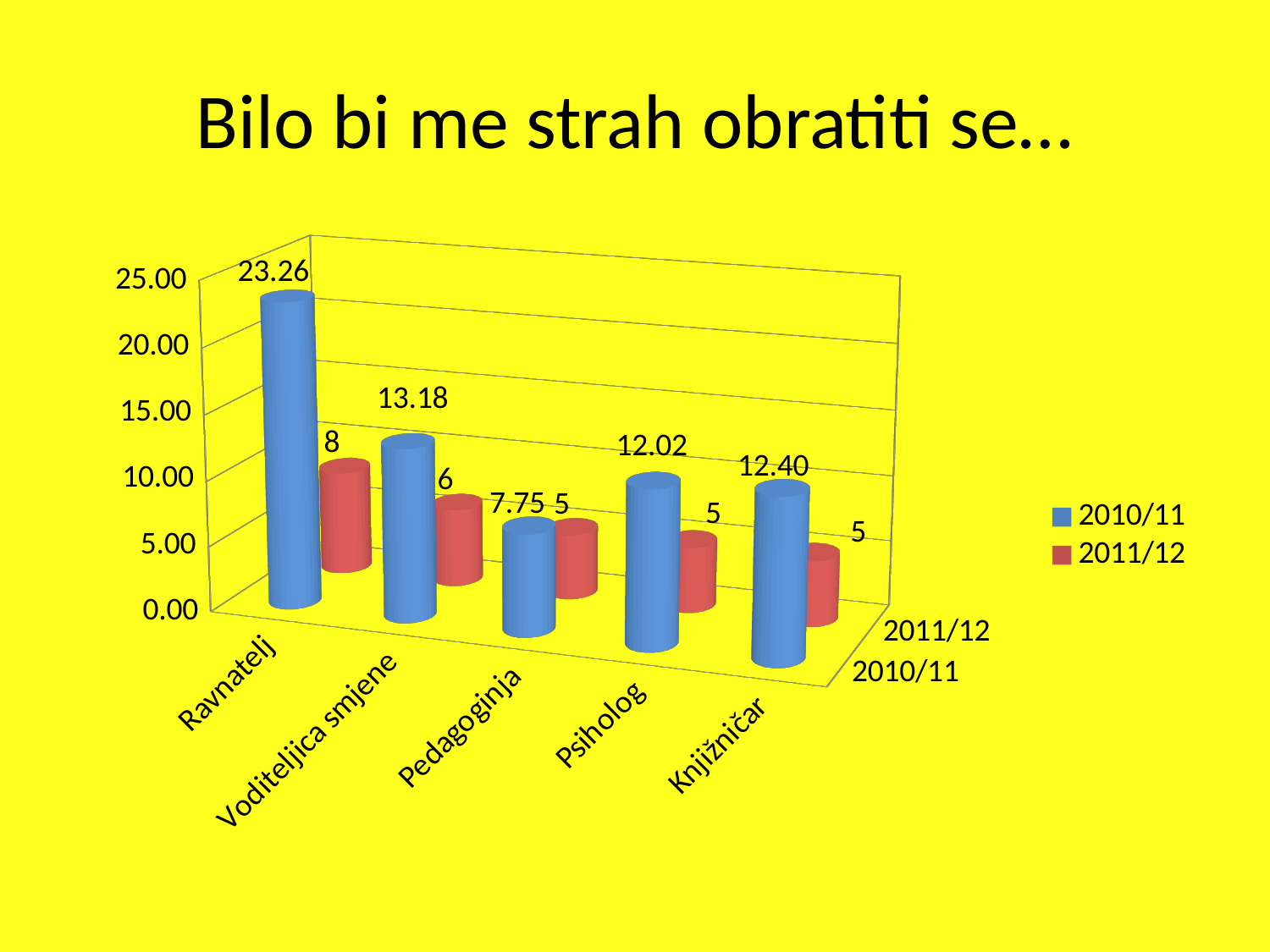
How many series does the legend list? 2 Which category has the highest value in the 2011/12 series? Ravnatelj What type of chart is shown on the slide? Bar chart What is the value for Voditeljica smjene in the 2011/12 series? 6 Which category has the highest value in the 2010/11 series? Ravnatelj Which category has the lowest value in the 2010/11 series? Pedagoginja What is the value for Knjižničar in the 2010/11 series? 12.40 What is the value for Ravnatelj in the 2010/11 series? 23.26 How many categories are shown on the x axis? 5 What is the value for Psiholog in the 2010/11 series? 12.02 What is the difference between the 2010/11 and 2011/12 values for Ravnatelj? 15.26 Which is larger for Pedagoginja: the 2010/11 value or the 2011/12 value? 2010/11